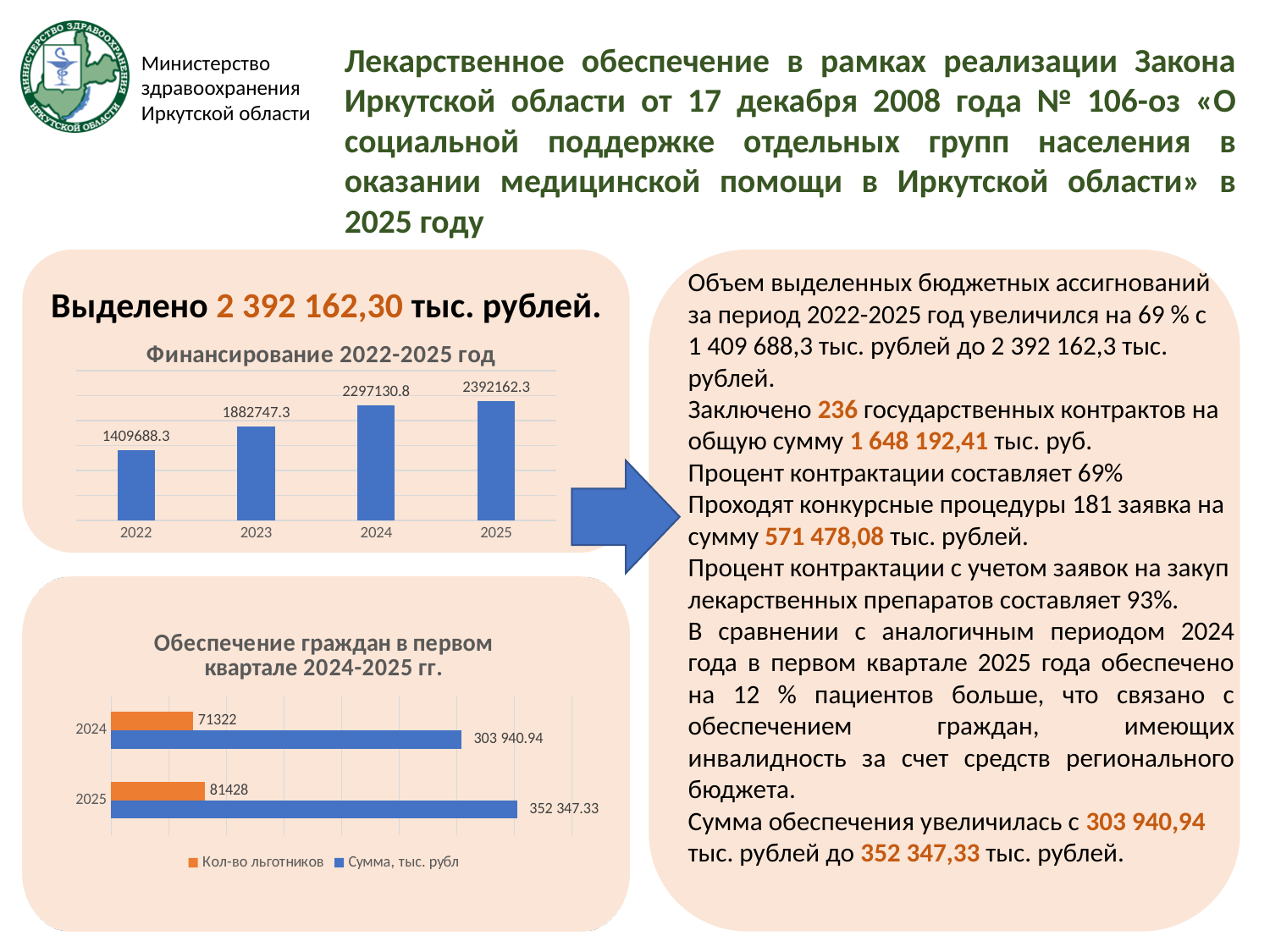
In the chart 'Финансирование 2022-2025 год', what is the value for 2024? 2297130.8 In the chart 'Финансирование 2022-2025 год', which year has the lowest value? 2022 In the chart 'Обеспечение граждан в первом квартале 2024-2025 гг.', what is the value of 'Кол-во льготников' for 2025? 81428 In the chart 'Обеспечение граждан в первом квартале 2024-2025 гг.', what is the value of 'Сумма, тыс. рубл' for 2024? 303 940.94 In the chart 'Финансирование 2022-2025 год', which year has the highest value? 2025 In the chart 'Финансирование 2022-2025 год', do the values rise or fall from 2022 to 2025? rise How many years are shown in the chart 'Финансирование 2022-2025 год'? 4 In the chart 'Обеспечение граждан в первом квартале 2024-2025 гг.', which year has the larger value of 'Кол-во льготников', 2024 or 2025? 2025 How many series does the legend of the chart 'Обеспечение граждан в первом квартале 2024-2025 гг.' list? 2 In the chart 'Финансирование 2022-2025 год', what is the difference between the values for 2025 and 2024? 95031.5 What kind of chart is 'Обеспечение граждан в первом квартале 2024-2025 гг.'? bar chart In the chart 'Финансирование 2022-2025 год', what is the value for 2022? 1409688.3